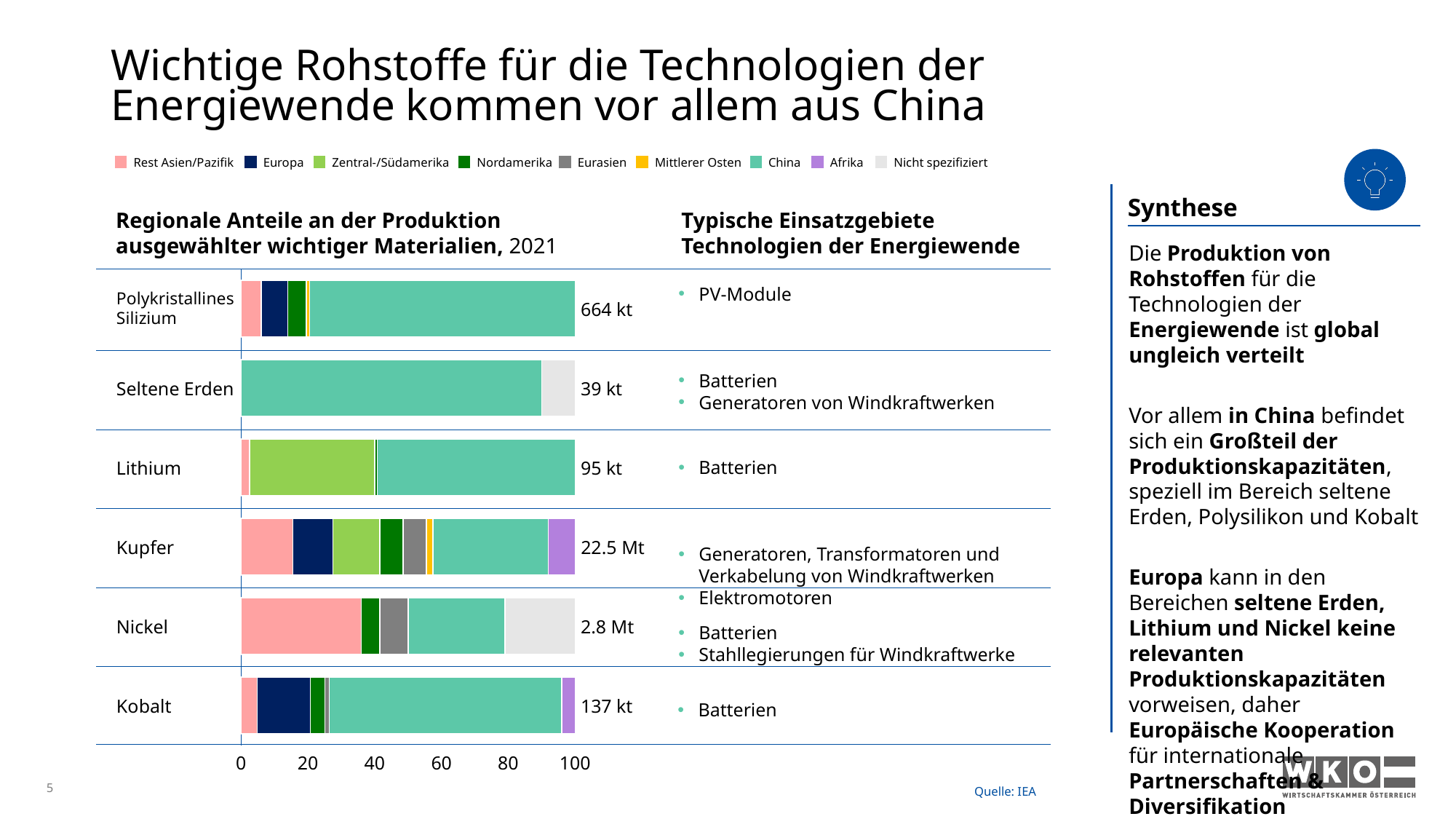
How many regions does the legend list? 9 Is the share of China in the production of Seltene Erden greater or less than 80? greater How many materials (categories) are shown in the chart? 6 Is the share of Zentral-/Südamerika in the production of Lithium greater or less than 20? greater What total production amount is printed next to the bar for Seltene Erden? 39 kt Which material has the largest share of production in China? Seltene Erden What kind of chart is shown on the slide? Stacked bar chart What total production amount is printed next to the bar for Kupfer? 22.5 Mt What total production amount is printed next to the bar for Polykristallines Silizium? 664 kt Is China's share of production larger for Seltene Erden or for Kupfer? Seltene Erden Is the share of Rest Asien/Pazifik in the production of Nickel greater or less than 20? greater What total production amount is printed next to the bar for Kobalt? 137 kt